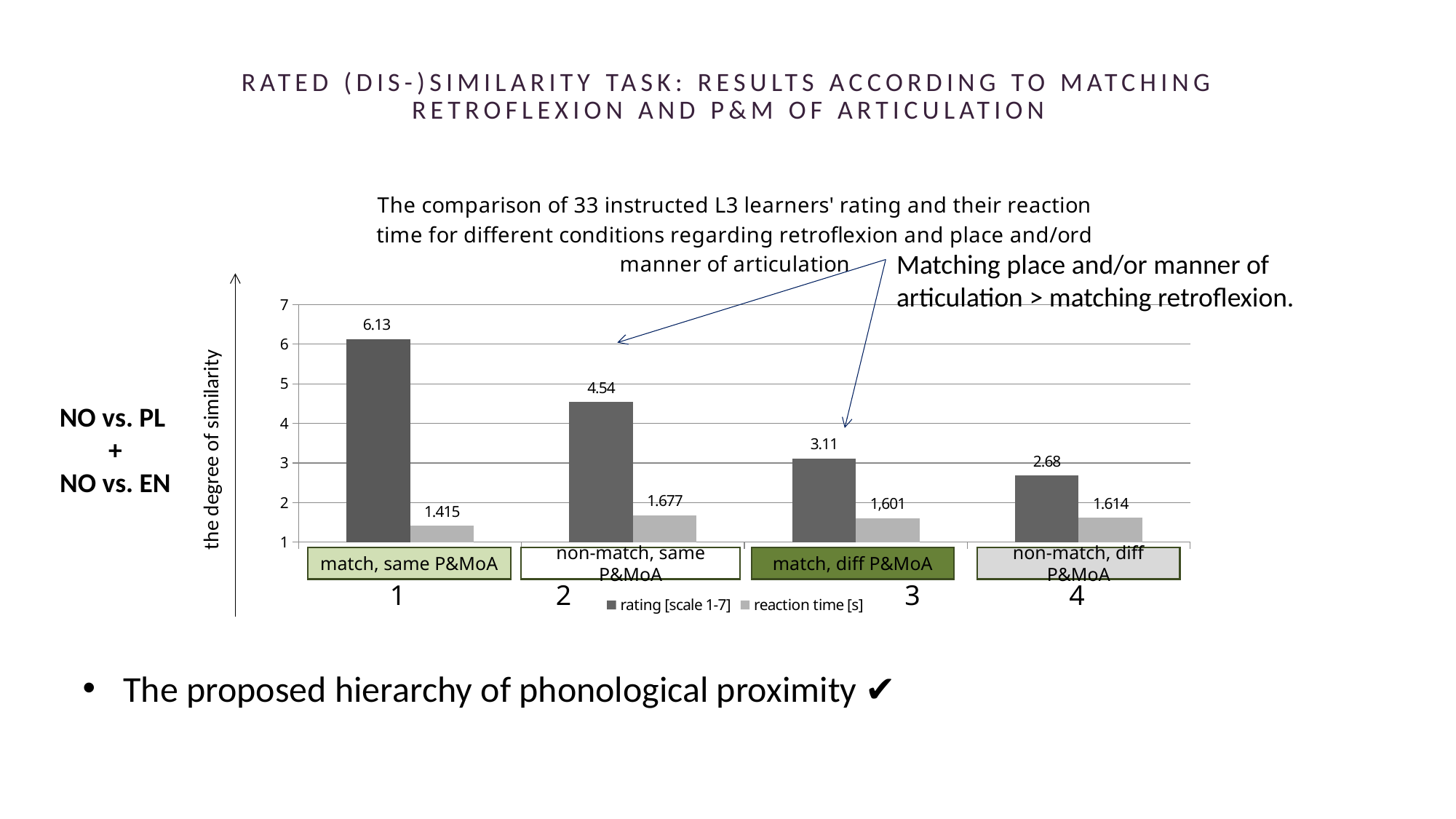
Which is larger: the rating for "match, diff P&MoA" or the rating for "non-match, diff P&MoA"? match, diff P&MoA How many conditions (categories) are shown on the x axis? 4 What is the difference between the rating for "match, same P&MoA" and the rating for "non-match, same P&MoA"? 1.59 What is the rating [scale 1-7] for the "non-match, diff P&MoA" condition? 2.68 What is the reaction time [s] for the "non-match, same P&MoA" condition? 1.677 What kind of chart is shown on the slide? Bar chart Which condition has the highest rating [scale 1-7]? match, same P&MoA How many series does the legend list? 2 What is the reaction time [s] for the "match, same P&MoA" condition? 1.415 Which condition has the lowest rating [scale 1-7]? non-match, diff P&MoA Do the rating [scale 1-7] values rise or fall from condition 1 to condition 4? Fall What is the rating [scale 1-7] for the "match, same P&MoA" condition? 6.13